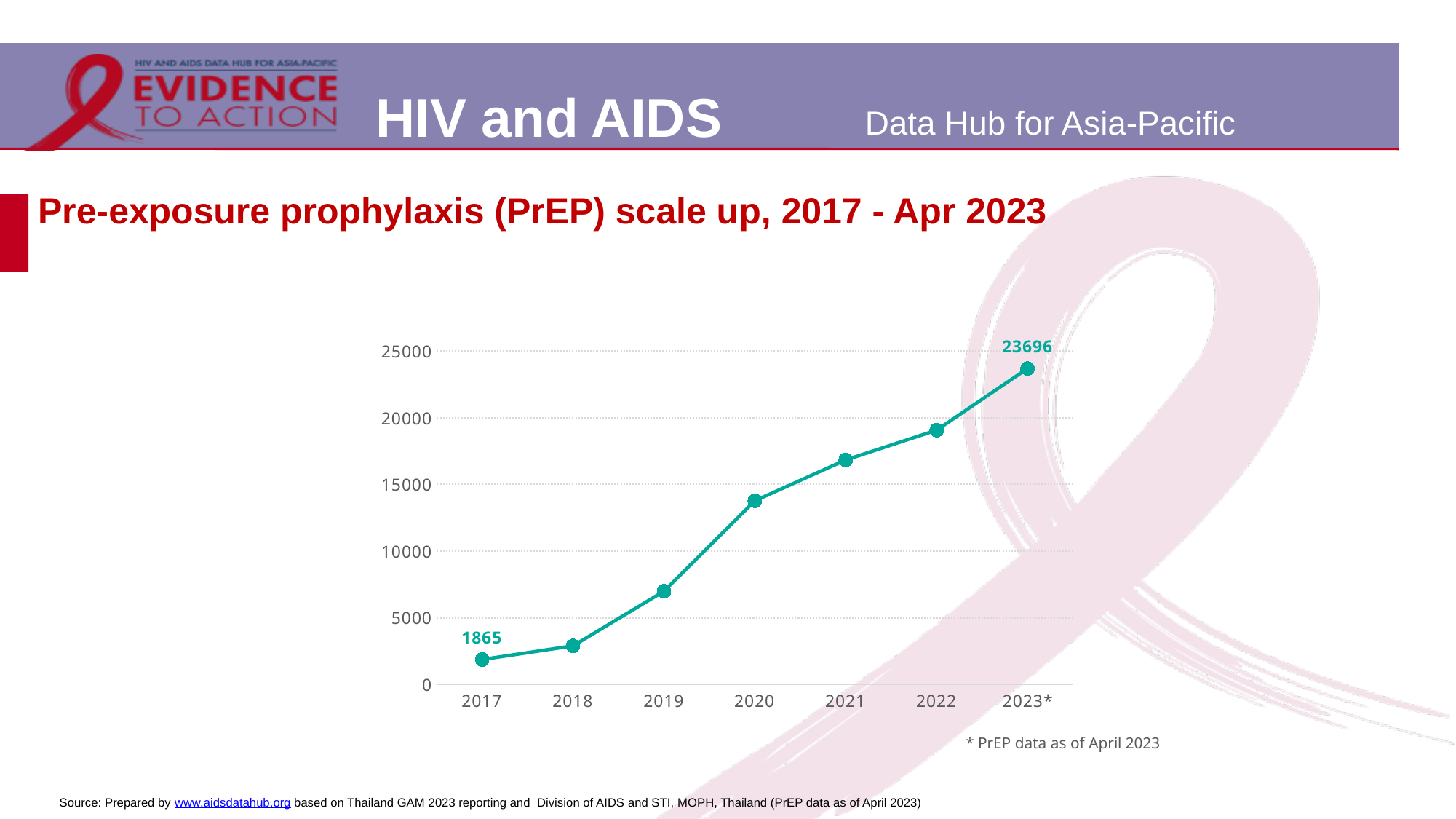
What is the value for 2023*? 23696 What is the difference between the values for 2023* and 2017? 21831 How many years are plotted on the chart? 7 What is the value for 2017? 1865 Do the values rise or fall from 2017 to 2023*? rise Is the value for 2021 greater or less than 15000? greater Which year has the highest value? 2023* Which year has the lowest value? 2017 Is the value for 2022 greater or less than 20000? less Is the value for 2019 greater or less than 10000? less Which is larger, the value for 2020 or the value for 2019? 2020 What kind of chart is shown? line chart